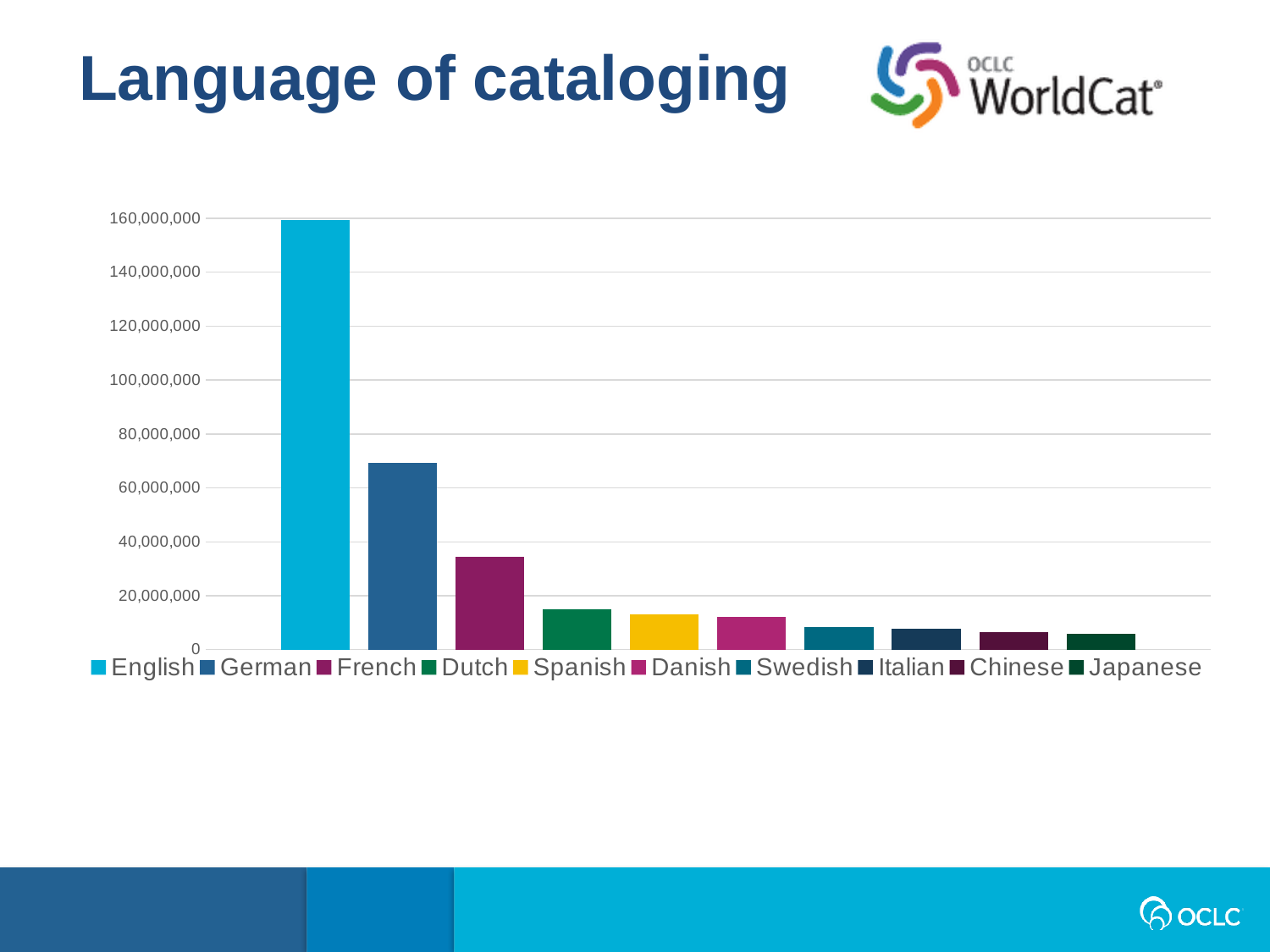
Which language has the highest value in the chart? English What kind of chart is shown on the slide? bar chart Is the value for French greater or less than 40,000,000? less How many entries does the legend list? 10 Is the value for Dutch greater or less than 20,000,000? less What is the title of the slide containing the chart? Language of cataloging Do the values rise or fall moving from left to right across the languages? fall Is the value for German greater or less than 60,000,000? greater Which has a larger value, German or French? German How many languages are plotted in the chart? 10